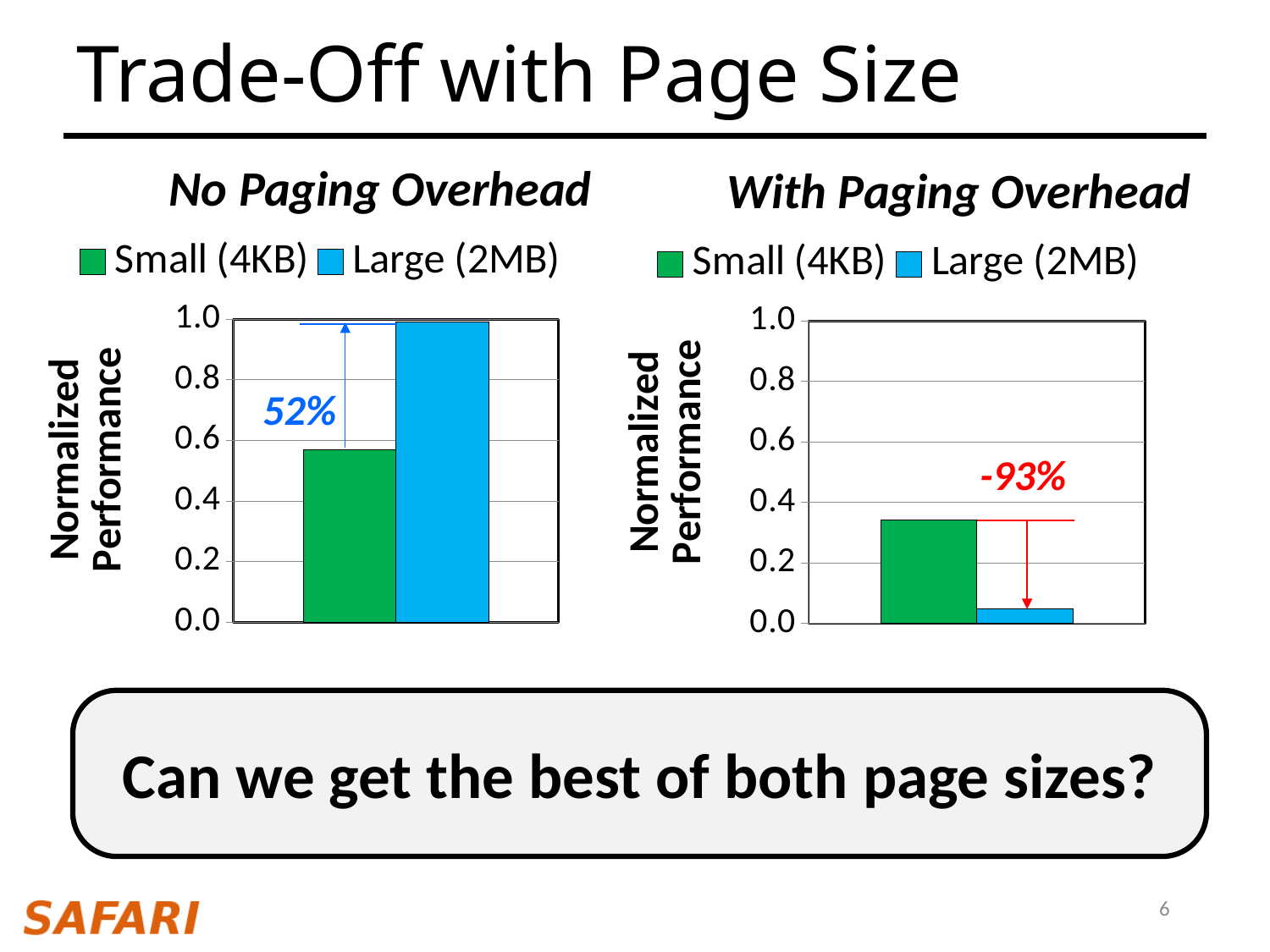
What percentage change is annotated on the "No Paging Overhead" chart? 52% In the "No Paging Overhead" chart, is the value for Large (2MB) greater or less than 0.8? greater What percentage change is annotated on the "With Paging Overhead" chart? -93% How many series does the legend of the "With Paging Overhead" chart list? 2 What kind of chart is the "No Paging Overhead" chart? bar chart In the "No Paging Overhead" chart, is the value for Small (4KB) greater or less than 0.6? less In the "With Paging Overhead" chart, is the value for Small (4KB) greater or less than 0.4? less What is the y-axis label of the "No Paging Overhead" chart? Normalized Performance In the "With Paging Overhead" chart, which series has the lowest normalized performance? Large (2MB) In the "No Paging Overhead" chart, which series has the higher normalized performance, Small (4KB) or Large (2MB)? Large (2MB) In the "With Paging Overhead" chart, which series has the higher normalized performance, Small (4KB) or Large (2MB)? Small (4KB)